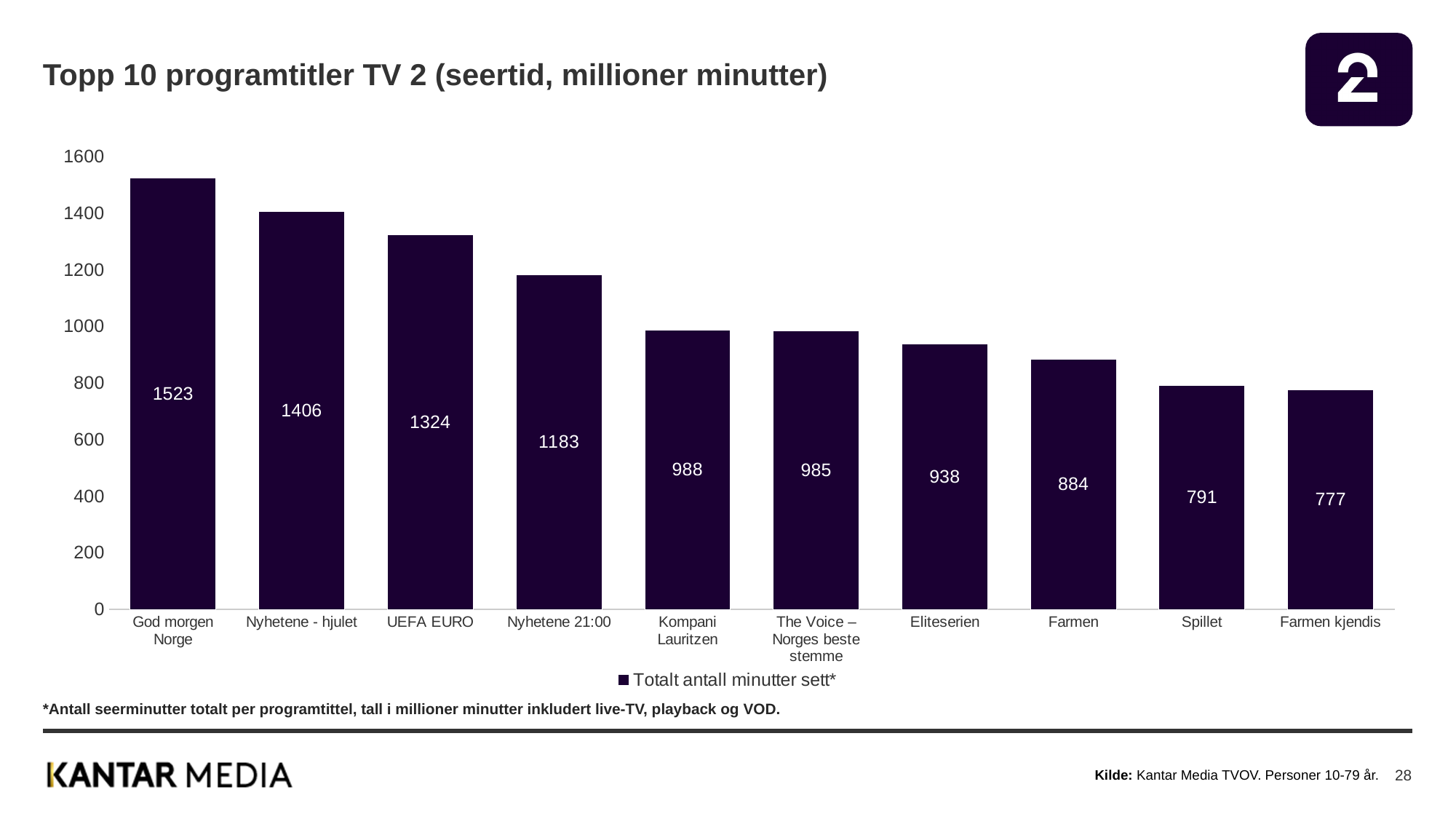
What is the value for Spillet? 791 What kind of chart is shown on the slide? bar chart How many program titles are shown on the chart? 10 Which is larger, the value for Eliteserien or the value for Farmen? Eliteserien What is the value for Kompani Lauritzen? 988 How many series does the legend list? 1 Which program title has the highest value? God morgen Norge What is the difference between the values for Nyhetene - hjulet and UEFA EURO? 82 Which program title has the lowest value? Farmen kjendis What is the value for God morgen Norge? 1523 Is the value for Nyhetene 21:00 greater or less than 1200? less What is the legend entry of the chart? Totalt antall minutter sett*